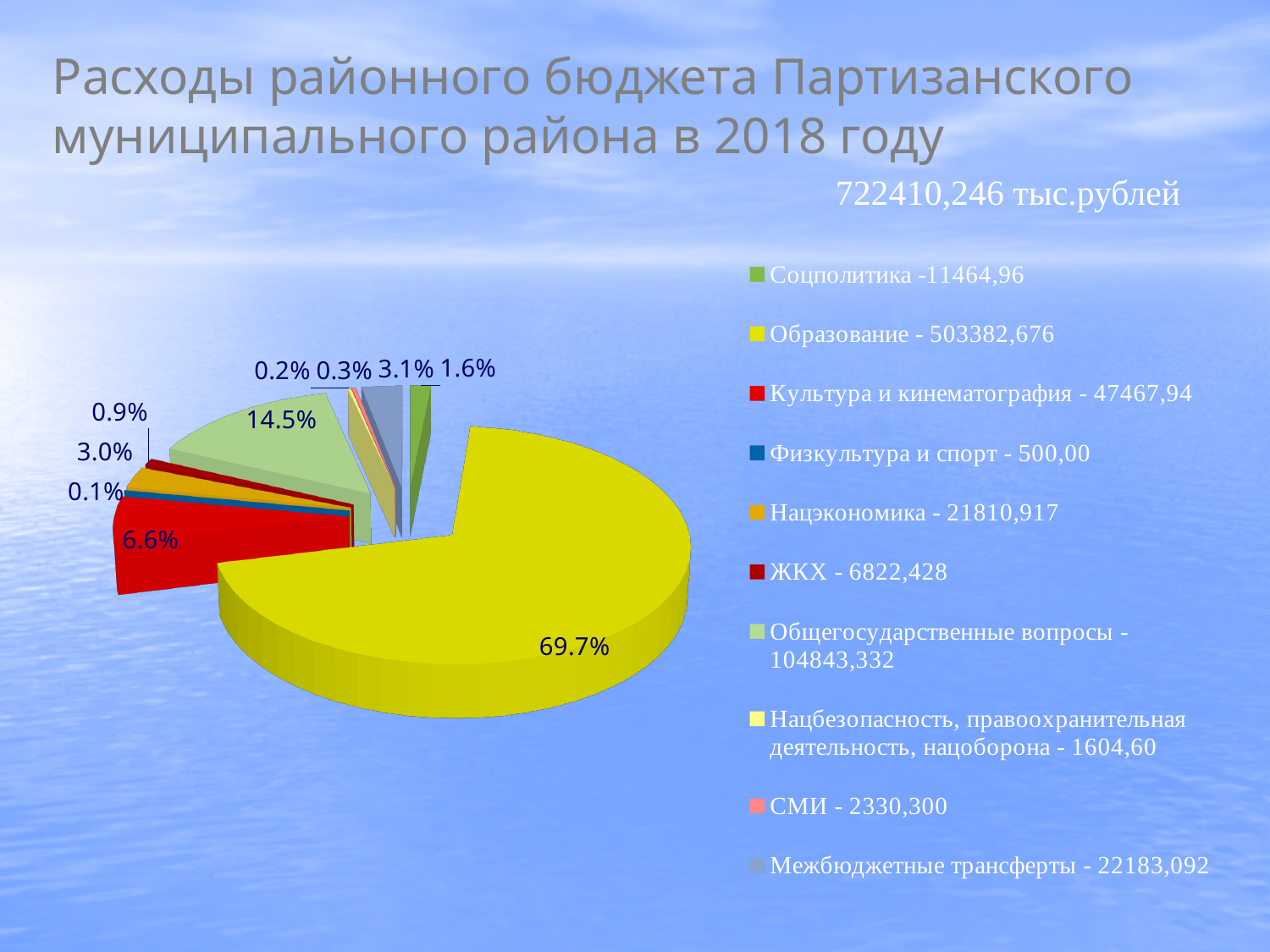
What value is given for Физкультура и спорт in the legend? 500,00 What share of the pie does Культура и кинематография (the red slice) account for? 6.6% What value is given for Межбюджетные трансферты in the legend? 22183,092 What total amount of expenditure is stated on the slide? 722410,246 тыс.рублей How many categories does the legend of the pie chart list? 10 What is the title of the slide? Расходы районного бюджета Партизанского муниципального района в 2018 году Which is larger according to the legend: Нацэкономика or ЖКХ? Нацэкономика What share of the pie does Образование account for? 69.7% What share of the pie does Общегосударственные вопросы (the light green slice) account for? 14.5% What value is given for Образование in the legend? 503382,676 Which category has the largest slice of the pie chart? Образование What kind of chart is shown on the slide? pie chart